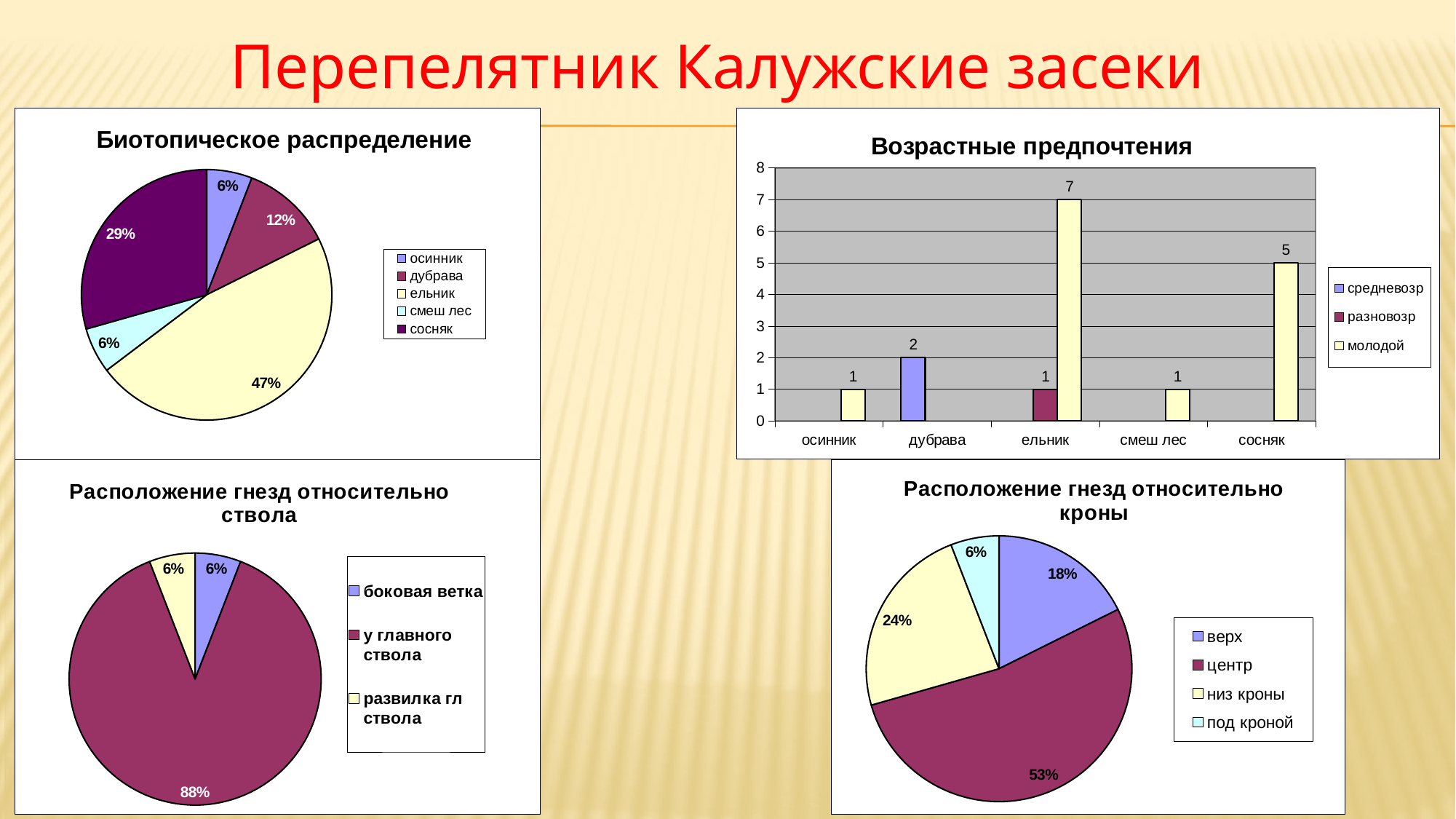
In the 'Расположение гнезд относительно ствола' pie chart, what share does у главного ствола have? 88% In the 'Биотопическое распределение' pie chart, what is the difference between the shares of сосняк and дубрава? 17% In the 'Возрастные предпочтения' chart, how many categories are shown on the x axis? 5 In the 'Возрастные предпочтения' bar chart, what is the value of средневозр for дубрава? 2 In the 'Расположение гнезд относительно кроны' pie chart, what share does низ кроны have? 24% In the 'Возрастные предпочтения' bar chart, which is larger: молодой for сосняк or молодой for ельник? молодой for ельник In the 'Расположение гнезд относительно кроны' pie chart, which category has the smallest share? под кроной In the 'Возрастные предпочтения' bar chart, how many series does the legend list? 3 What kind of chart is 'Возрастные предпочтения'? bar chart In the 'Биотопическое распределение' pie chart, what share does ельник have? 47% In the 'Биотопическое распределение' pie chart, which category has the largest share? ельник In the 'Возрастные предпочтения' bar chart, what is the value of молодой for ельник? 7